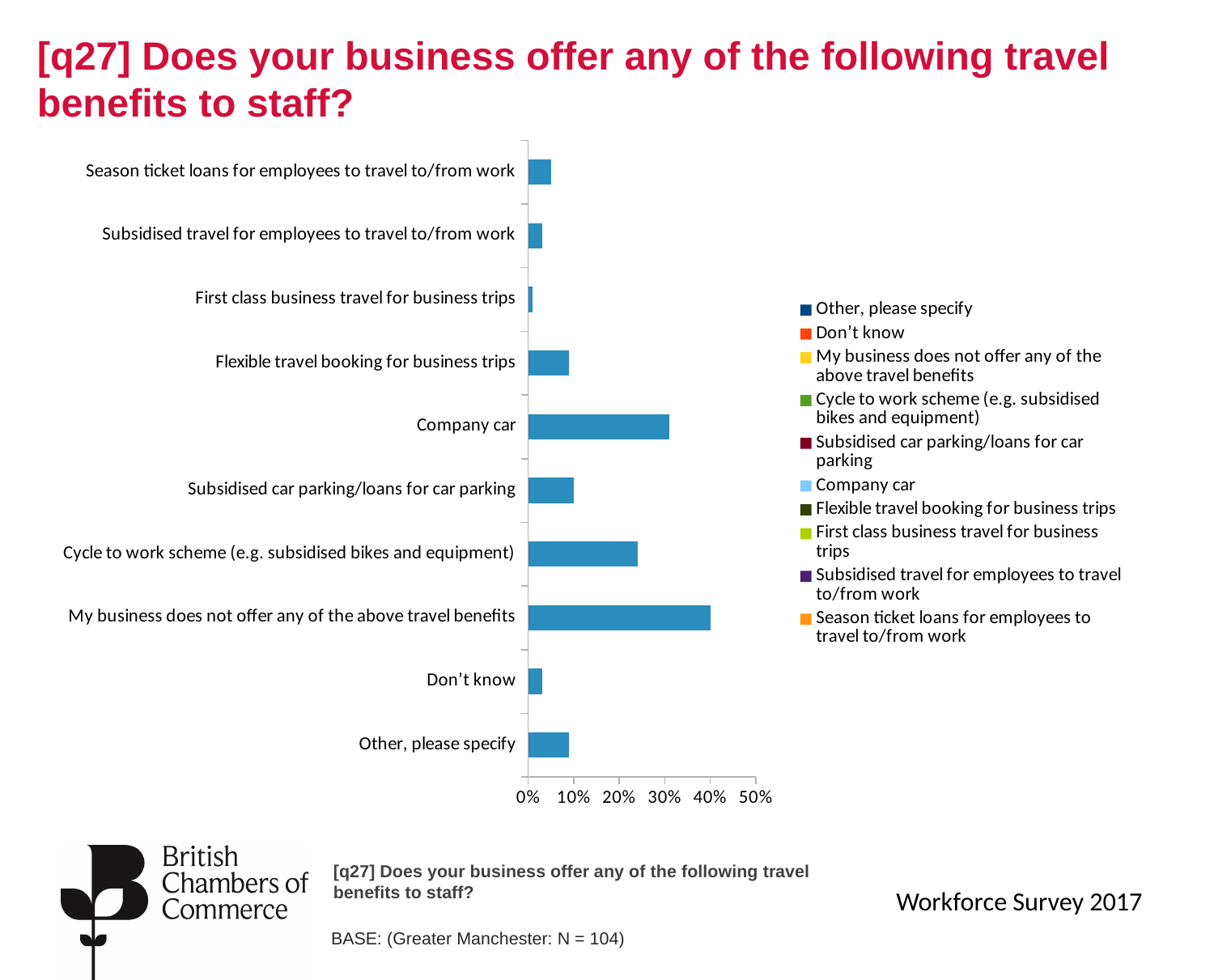
What is the highest percentage tick shown on the chart's horizontal axis? 50% Is the value for Season ticket loans for employees to travel to/from work greater or less than 10%? less Is the value for My business does not offer any of the above travel benefits greater or less than 30%? greater What kind of chart is shown on the slide? Bar chart Which category has the highest value in the chart? My business does not offer any of the above travel benefits How many categories are plotted in the chart? 10 Which is larger: the value for Season ticket loans for employees to travel to/from work or the value for First class business travel for business trips? Season ticket loans for employees to travel to/from work Which category has the lowest value in the chart? First class business travel for business trips Is the value for Cycle to work scheme (e.g. subsidised bikes and equipment) greater or less than 30%? less Which is larger: the value for Company car or the value for Cycle to work scheme (e.g. subsidised bikes and equipment)? Company car How many entries does the chart's legend list? 10